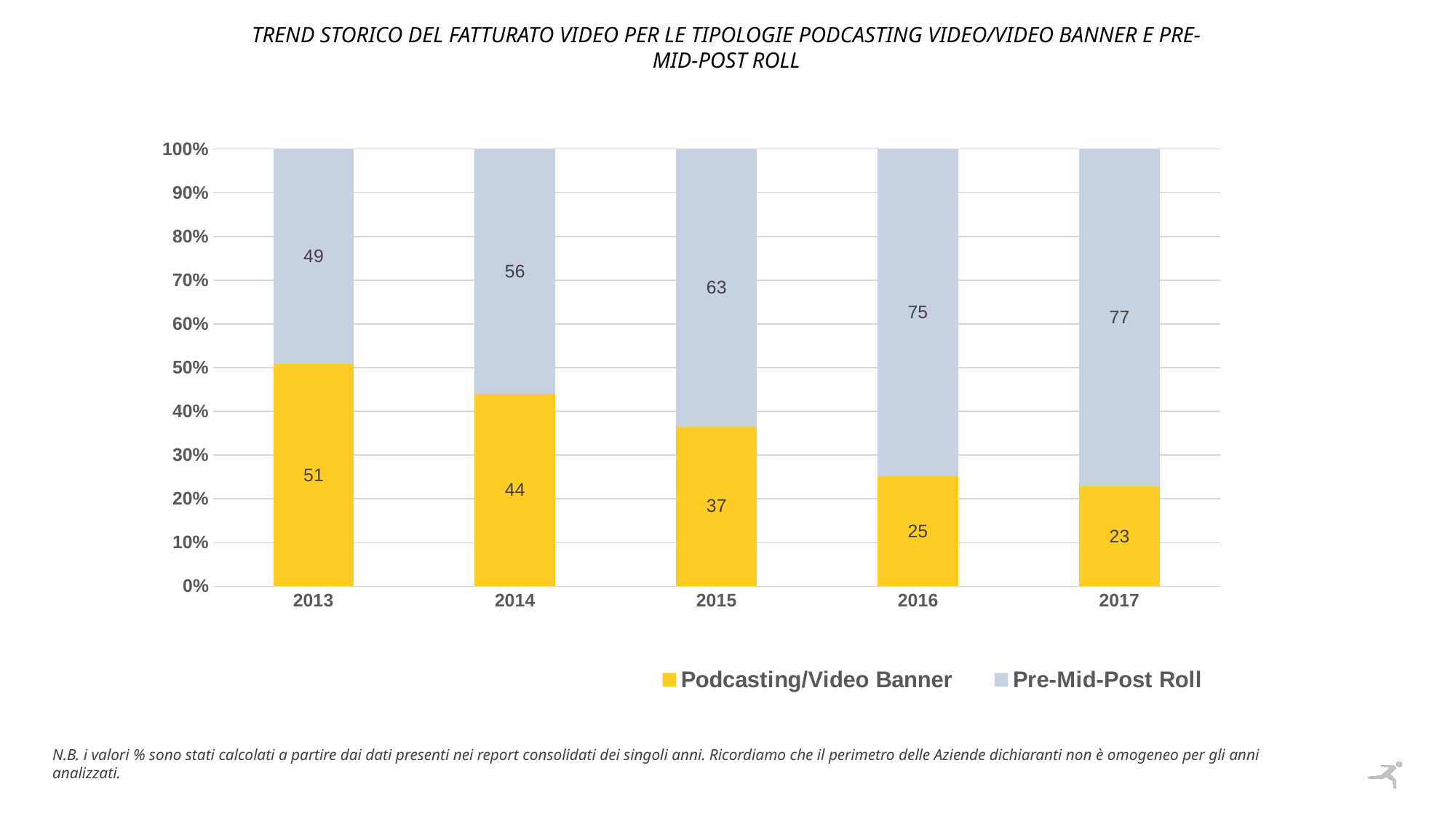
What is the value for Pre-Mid-Post Roll in 2017? 77 How many years are shown on the x axis? 5 In which year is the Pre-Mid-Post Roll value lowest? 2013 Does the Podcasting/Video Banner value rise or fall from 2013 to 2017? Fall How many series does the legend list? 2 In which year is the Podcasting/Video Banner value highest? 2013 Which is larger in 2014: Podcasting/Video Banner or Pre-Mid-Post Roll? Pre-Mid-Post Roll What kind of chart is shown on the slide? Stacked bar chart What is the value for Pre-Mid-Post Roll in 2015? 63 Which colour represents Podcasting/Video Banner in the chart? Yellow What is the value for Podcasting/Video Banner in 2013? 51 What is the difference between the Pre-Mid-Post Roll value and the Podcasting/Video Banner value in 2016? 50